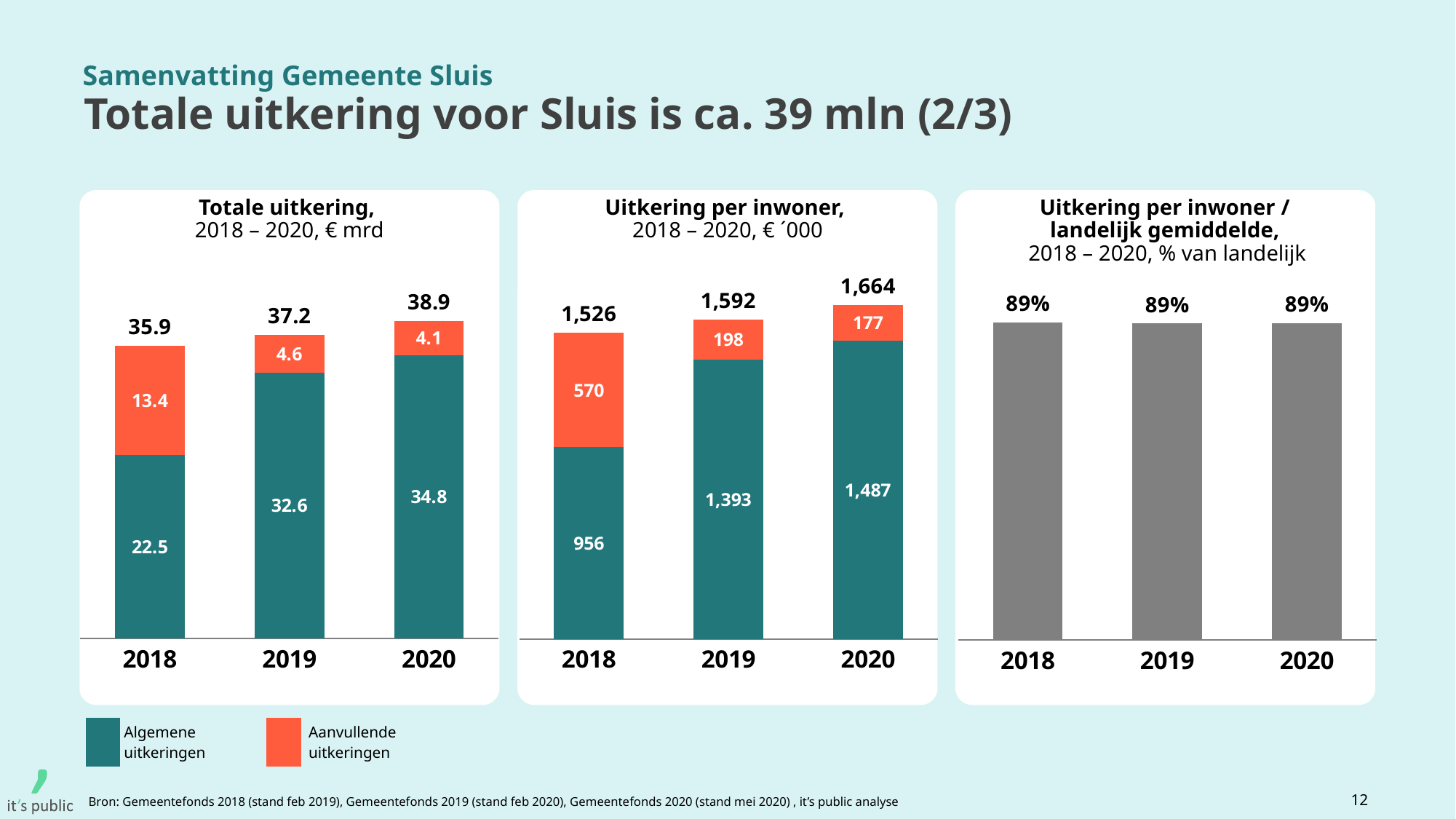
In the 'Totale uitkering' chart, what is the value of Algemene uitkeringen for 2018? 22.5 How many series does the legend at the bottom of the slide list? 2 In the 'Uitkering per inwoner' chart, is the Algemene uitkeringen value larger in 2019 or 2020? 2020 In the 'Totale uitkering' chart, which year has the highest total? 2020 In the 'Uitkering per inwoner' chart, which year has the lowest Algemene uitkeringen value? 2018 In the 'Uitkering per inwoner' chart, what is the value of Aanvullende uitkeringen for 2019? 198 In the 'Totale uitkering' chart, what is the difference between the Aanvullende uitkeringen values for 2018 and 2019? 8.8 What kind of chart is the 'Totale uitkering' chart? Stacked bar chart In the 'Uitkering per inwoner / landelijk gemiddelde' chart, how many years are shown? 3 In the 'Uitkering per inwoner / landelijk gemiddelde' chart, what is the value for 2020? 89% In the 'Uitkering per inwoner' chart, what is the total for 2018? 1,526 In the 'Totale uitkering' chart, what is the total of the stacked bar for 2020? 38.9